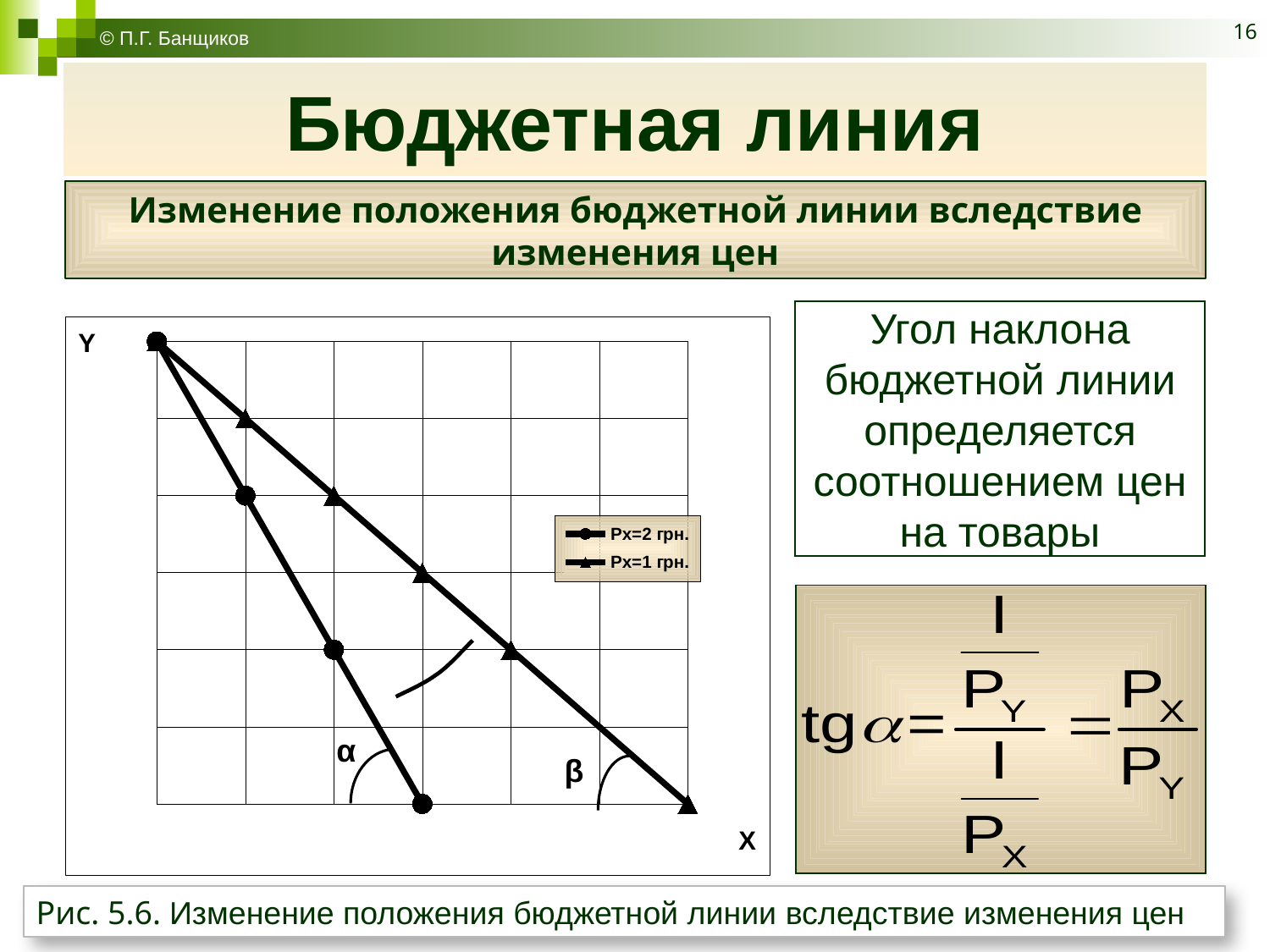
What kind of chart is shown on the slide? line chart How many series does the legend of the chart list? 2 Do the values of the Px=1 грн. series rise or fall as X increases? fall What labels are given to the horizontal and vertical axes of the chart? X and Y Do the values of the Px=2 грн. series rise or fall as X increases? fall Which series reaches the X axis farther from the origin, Px=2 грн. or Px=1 грн.? Px=1 грн. Which series has the steeper line, Px=2 грн. or Px=1 грн.? Px=2 грн. What are the two series named in the chart legend? Px=2 грн. and Px=1 грн.